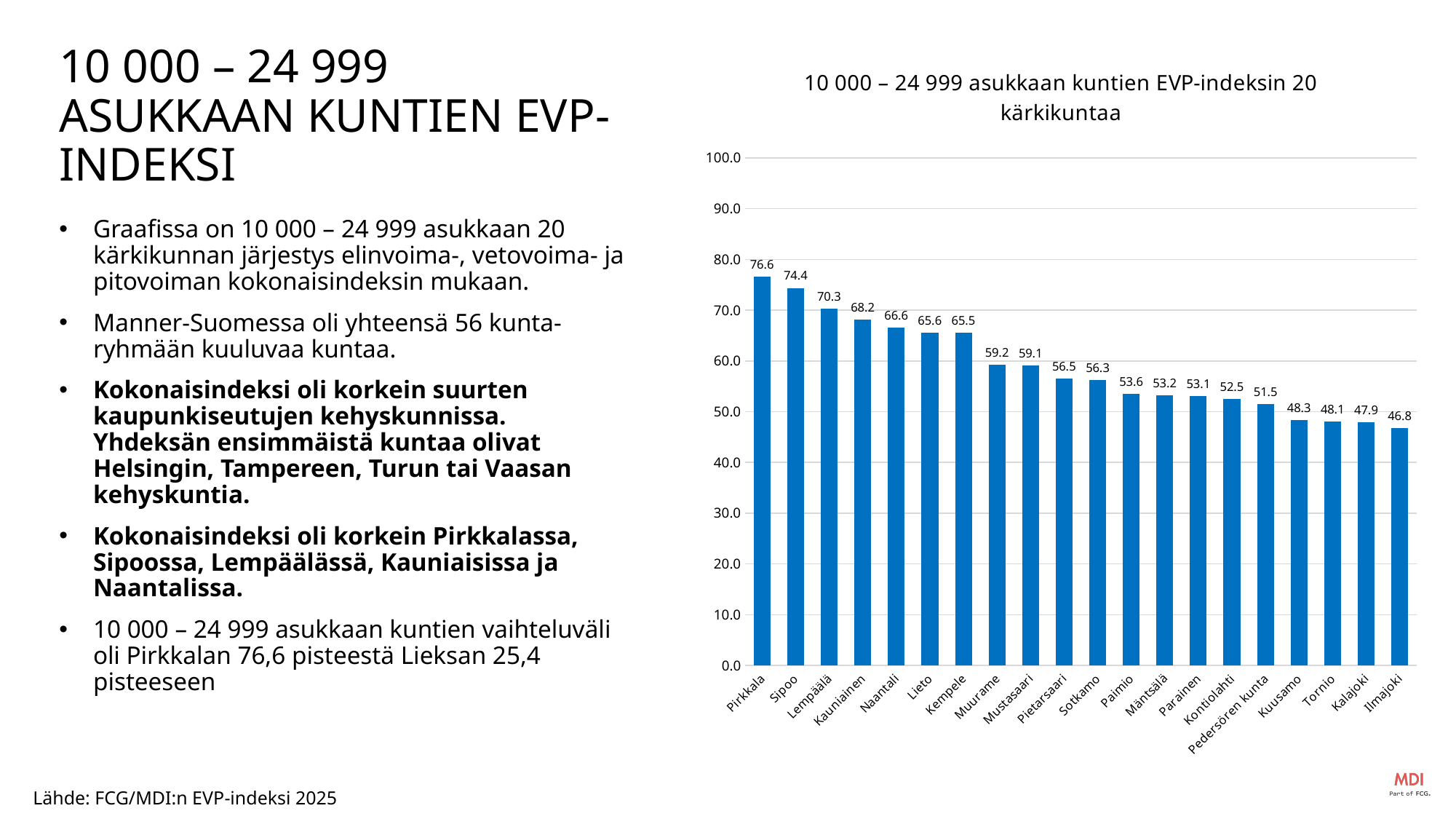
Do the values rise or fall from left to right along the x axis? fall Which municipality has the highest EVP index value in the chart? Pirkkala Is the value for Sotkamo greater or less than 60.0? less What is the EVP index value for Naantali? 66.6 Which municipality has the lowest EVP index value in the chart? Ilmajoki How many municipalities are shown in the chart? 20 What type of chart is shown on the slide? bar chart What is the difference between the EVP index values of Pirkkala and Sipoo? 2.2 Which has a higher EVP index value, Kauniainen or Muurame? Kauniainen What is the difference between the EVP index values of Lempäälä and Ilmajoki? 23.5 What is the EVP index value for Pirkkala? 76.6 What is the EVP index value for Pedersören kunta? 51.5